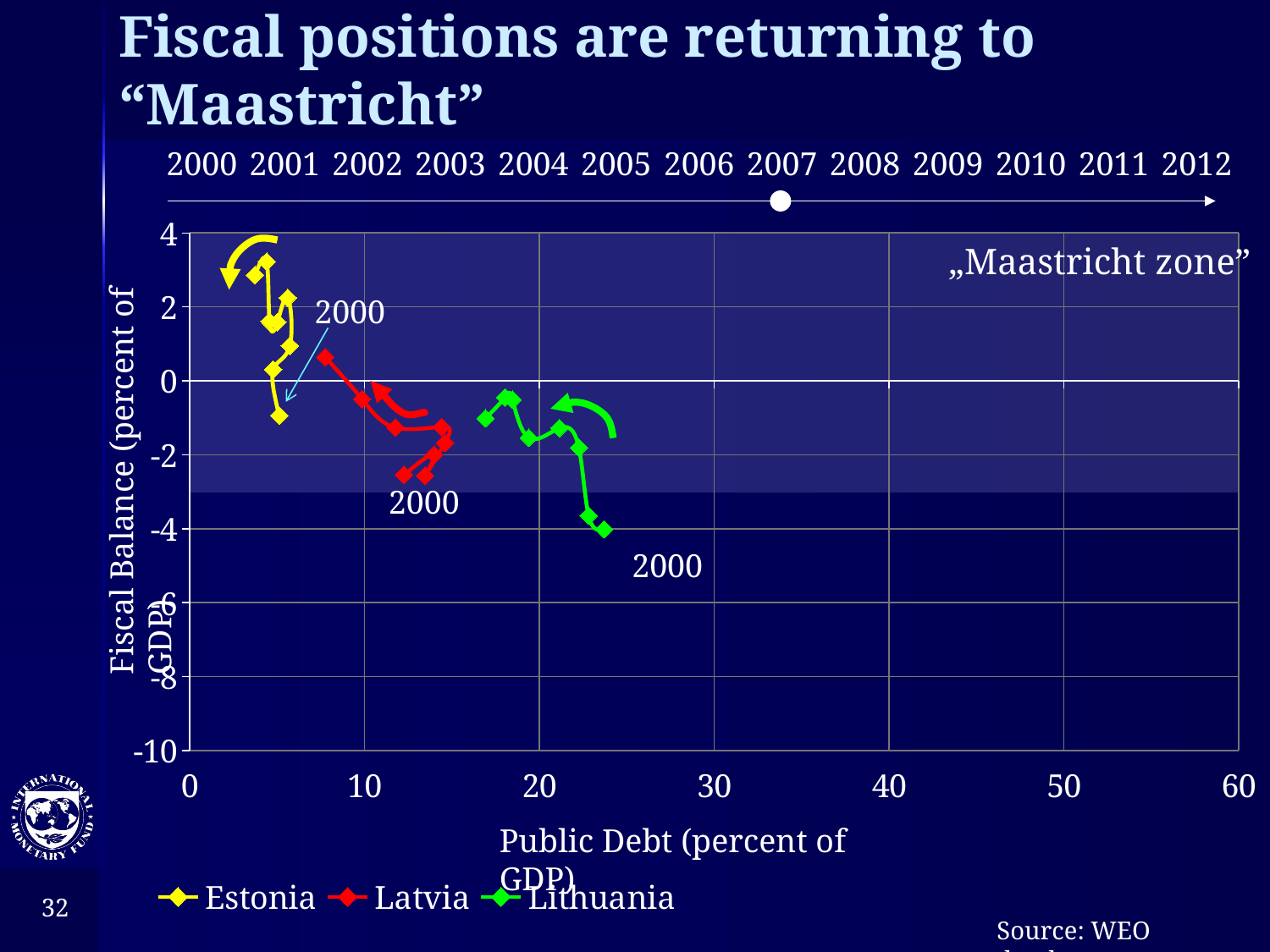
What is the label of the x axis? Public Debt (percent of GDP) How many series does the legend list? 3 Which countries are listed in the legend? Estonia, Latvia, Lithuania Is the public debt for Lithuania's 2000 point greater or less than 20? greater Which country has higher public debt, Estonia or Lithuania? Lithuania Which country's points lie at the lowest public debt levels? Estonia Which country's points lie at the highest public debt levels? Lithuania Is the fiscal balance for Latvia's 2000 point greater or less than 0? less What kind of chart is shown on the slide? scatter chart (points connected by lines) Is the fiscal balance for Lithuania's 2000 point greater or less than -2? less How many years are shown on the timeline above the chart? 13